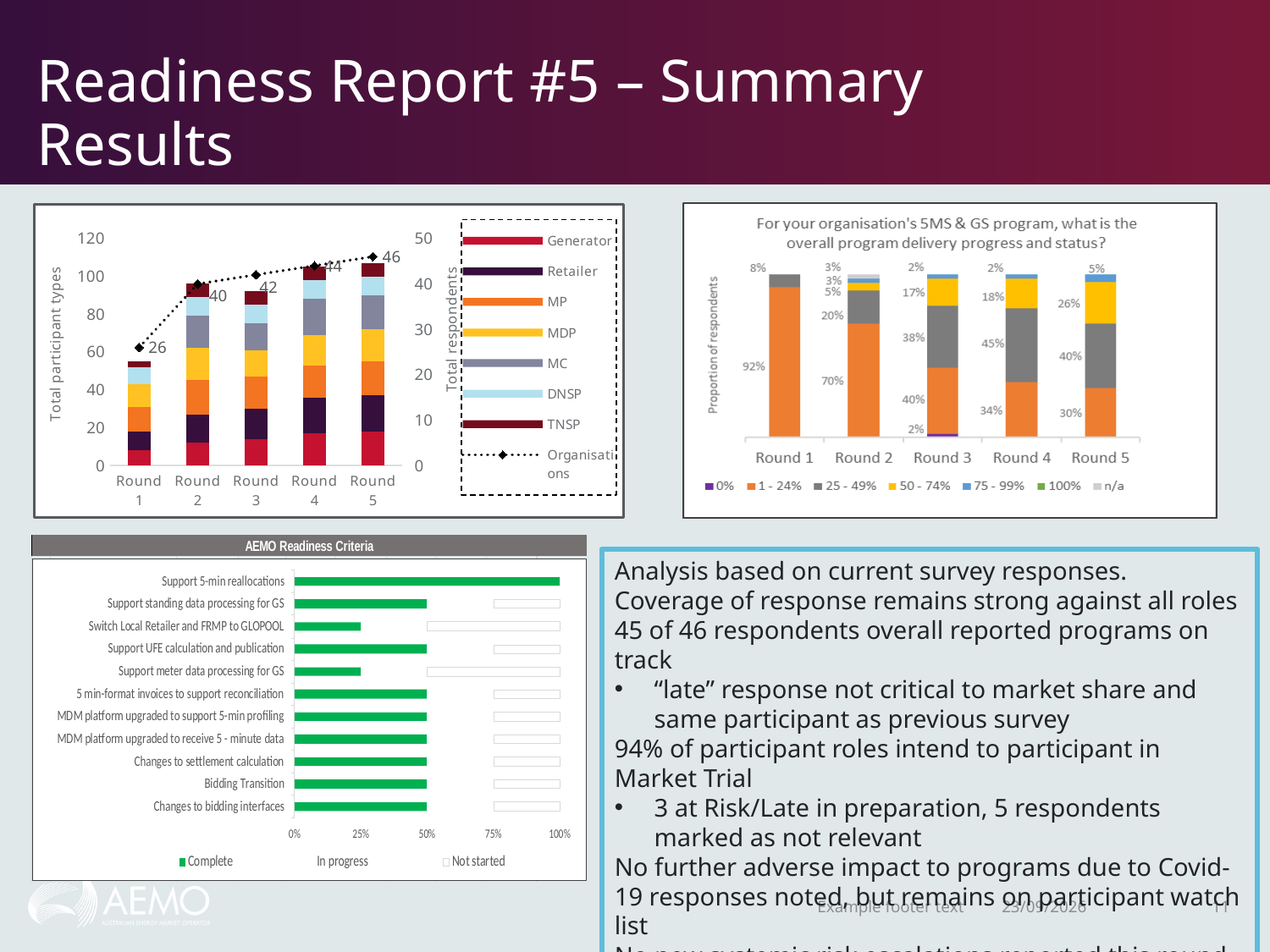
In the top-left chart, what is the Organisations value for Round 1? 26 In the top-right chart on program delivery progress, which round has the larger 1 - 24% share, Round 1 or Round 5? Round 1 In the AEMO Readiness Criteria chart, how many criteria are listed? 11 In the top-right chart on program delivery progress, what share of respondents reported 25 - 49% in Round 5? 40% What kind of chart is the AEMO Readiness Criteria chart? bar chart In the top-left chart, does the Organisations line rise or fall from Round 1 to Round 5? rise In the top-right chart on program delivery progress, what share of respondents reported 1 - 24% in Round 1? 92% How many series does the legend of the top-right chart on program delivery progress list? 7 How many entries does the legend of the top-left chart list? 8 In the top-left chart, what is the Organisations value for Round 5? 46 In the top-left chart, by how much does the Organisations value increase from Round 1 to Round 5? 20 In the AEMO Readiness Criteria chart, which criterion is shown as 100% complete? Support 5-min reallocations